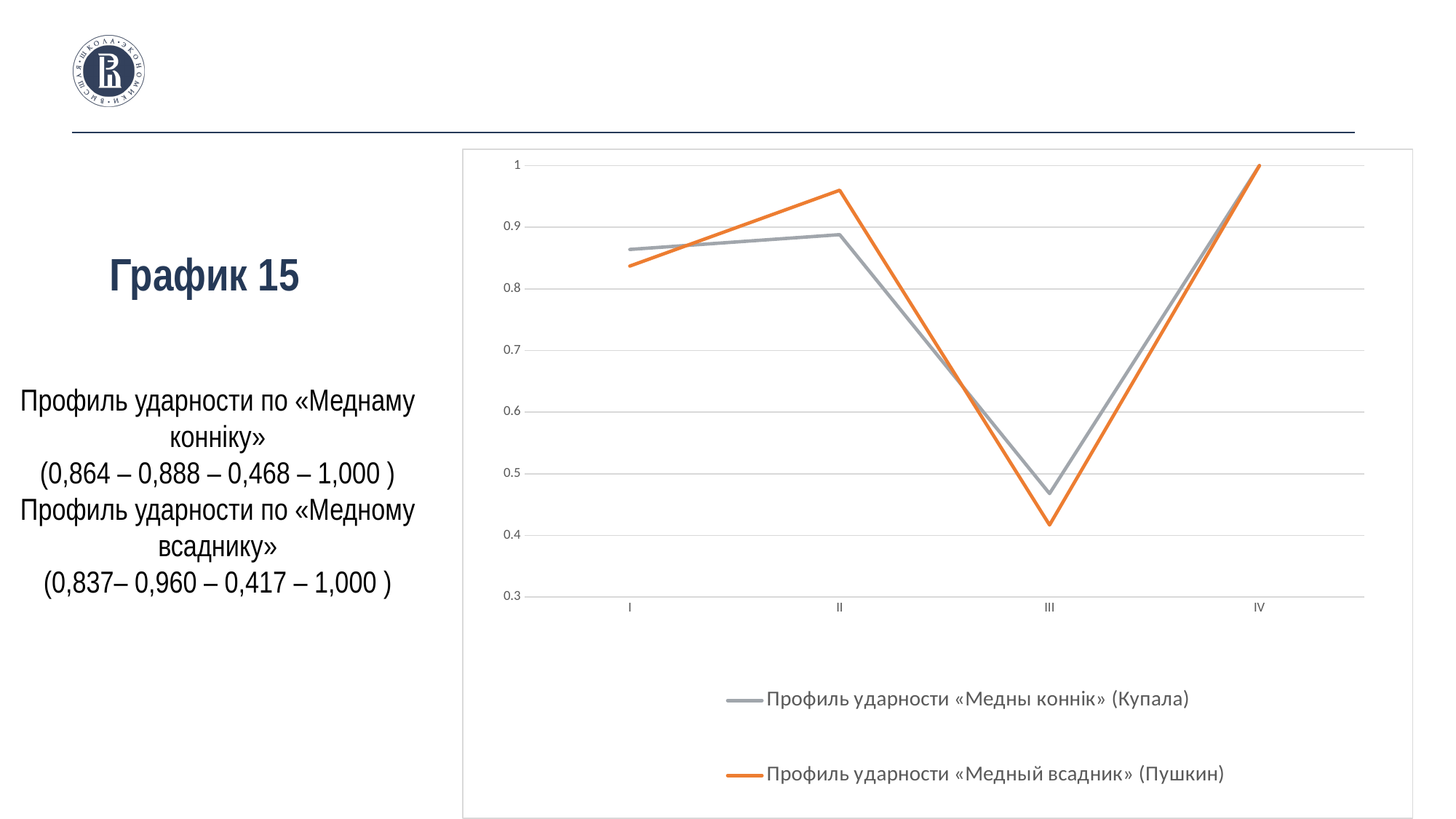
What is the difference between the Купала and Пушкин values at point III? 0,051 What is the value of the Купала series (Профиль ударности «Медны коннік») at point III? 0,468 How many series does the legend list? 2 What kind of chart is shown on the slide? line chart Which series has the larger value at point II, Купала or Пушкин? Пушкин At which x-axis point is the Пушкин series lowest? III Is the value of the Пушкин series at point III greater or less than 0.5? less What is the value of the Пушкин series (Профиль ударности «Медный всадник») at point II? 0,960 Which colour is used for the Пушкин series line? orange At which x-axis point is the Купала series highest? IV How many points are plotted along the x axis for each series? 4 Is the value of the Купала series at point I greater or less than 0.8? greater